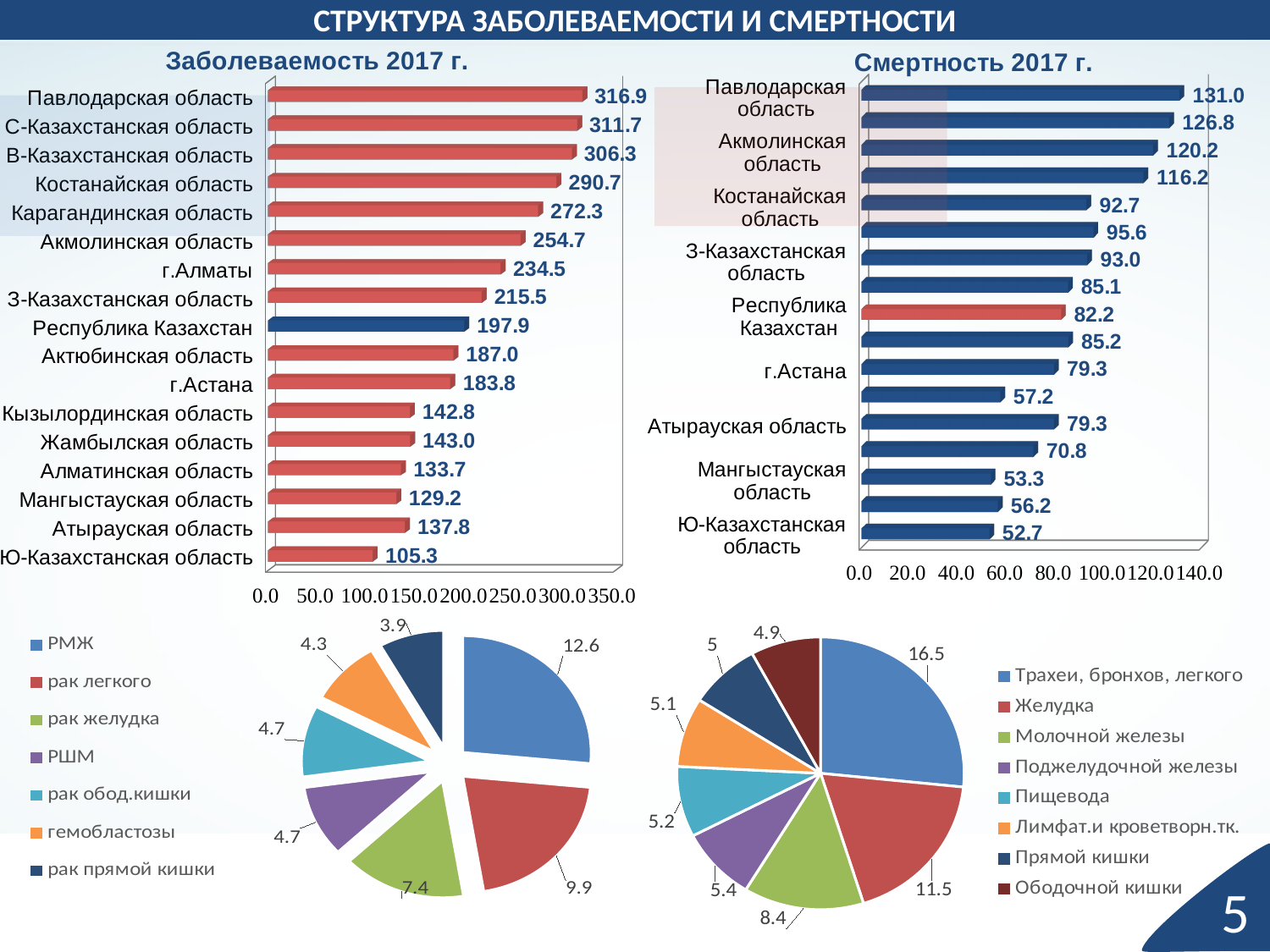
In the 'Заболеваемость 2017 г.' bar chart, which region has the lowest value? Ю-Казахстанская область What type of chart is used for 'Смертность 2017 г.'? bar chart In the bottom-left pie chart, what is the value for РМЖ? 12.6 How many regions are shown in the 'Заболеваемость 2017 г.' bar chart? 17 In the 'Смертность 2017 г.' bar chart, is the value for Ю-Казахстанская область greater or less than 60.0? less In the bottom-right pie chart, what is the difference between 'Трахеи, бронхов, легкого' and 'Желудка'? 5.0 In the 'Смертность 2017 г.' bar chart, what is the highest value shown? 131.0 In the 'Заболеваемость 2017 г.' bar chart, which is larger: г.Алматы or г.Астана? г.Алматы In the 'Смертность 2017 г.' bar chart, what is the value for Республика Казахстан (the red bar)? 82.2 How many entries does the legend of the bottom-right pie chart list? 8 In the 'Заболеваемость 2017 г.' bar chart, what is the difference between Павлодарская область and Республика Казахстан? 119.0 In the 'Заболеваемость 2017 г.' bar chart, what is the value for Павлодарская область? 316.9